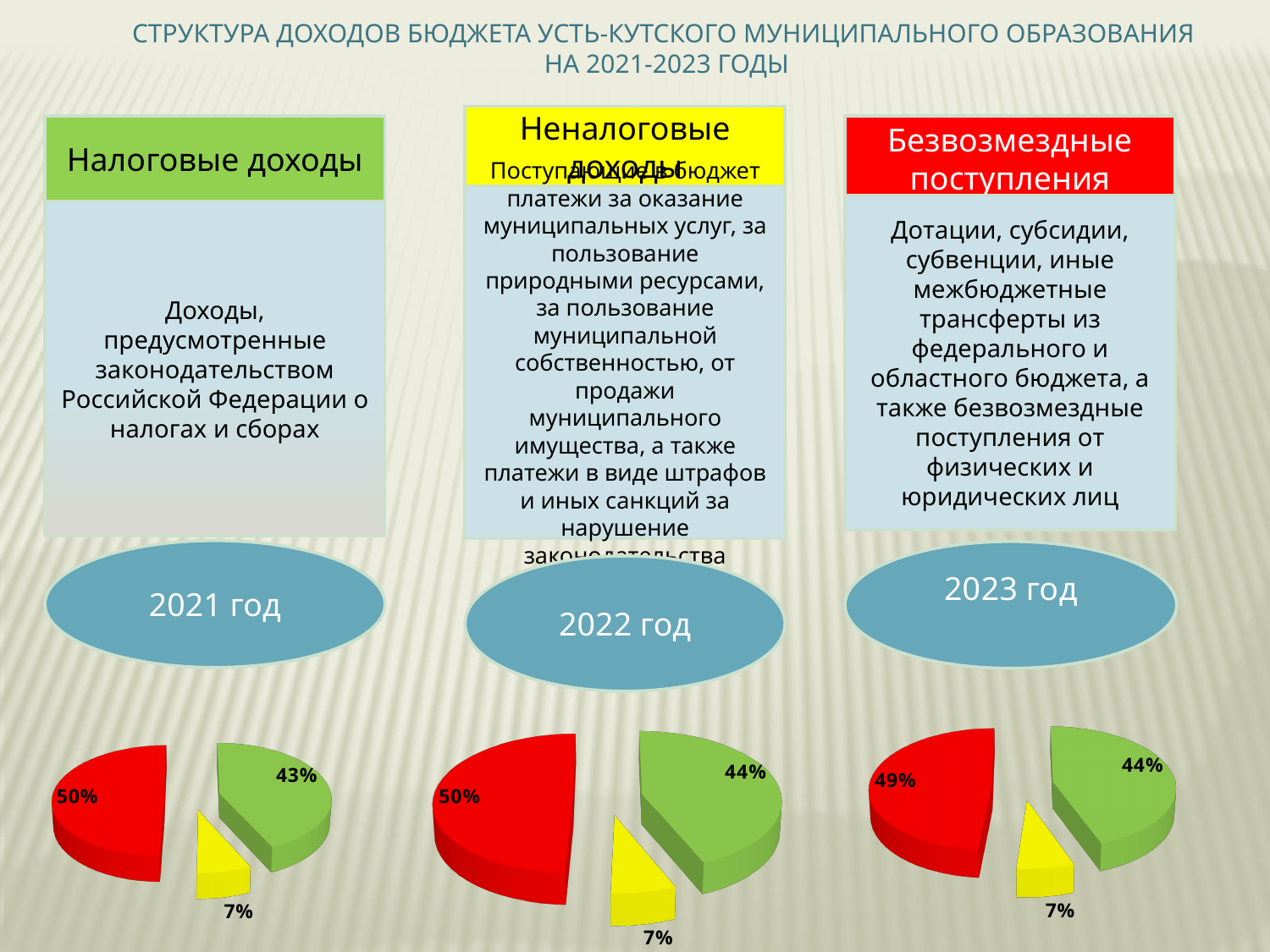
How many pie charts are shown on the slide? 3 In the 2023 год pie chart, is the red slice or the green slice larger? the red slice How many slices does each pie chart on the slide have? 3 In the 2021 год pie chart, what is the value of the red slice? 50% In the 2021 год pie chart, what is the difference between the red slice and the green slice? 7 percentage points What kind of chart is used for the 2021 год data? pie chart In the 2023 год pie chart, what is the value of the red slice? 49% In the 2021 год pie chart, what is the value of the green slice? 43% In the 2021 год pie chart, which slice is the largest? the red slice (50%) In the 2022 год pie chart, which slice is the smallest? the yellow slice (7%) In the 2022 год pie chart, what is the value of the green slice? 44% In the 2023 год pie chart, what is the value of the yellow slice? 7%